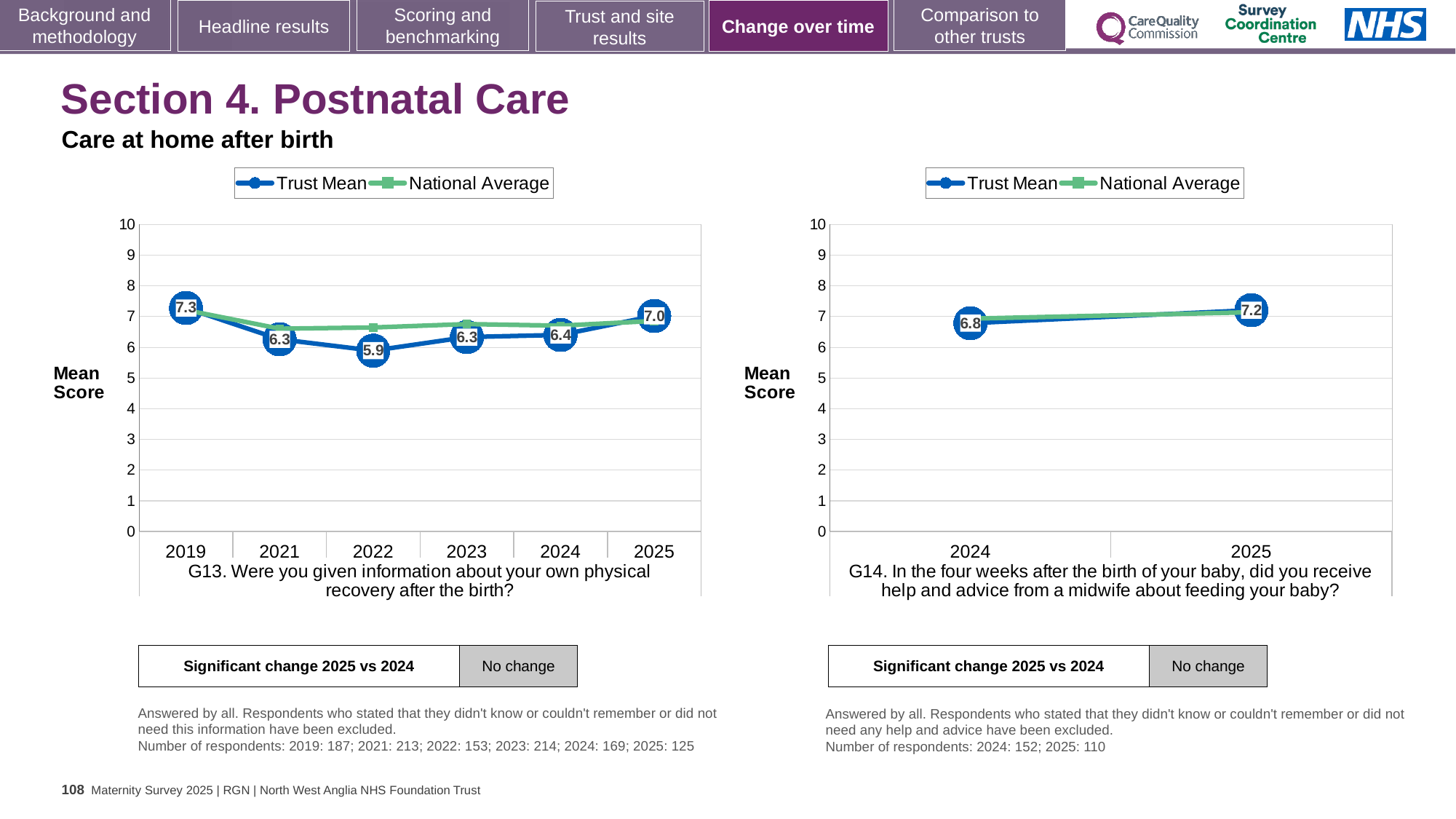
In the G14 chart on the right, what is the difference between the Trust Mean scores for 2025 and 2024? 0.4 In the G13 chart on the left, which year has the highest Trust Mean score? 2019 In the G13 chart on the left, what is the Trust Mean score for 2022? 5.9 In the G14 chart on the right, does the Trust Mean rise or fall from 2024 to 2025? rise In the G13 chart on the left, which year has the lowest Trust Mean score? 2022 In the G13 chart on the left, what is the Trust Mean score for 2019? 7.3 In the G14 chart on the right, what is the Trust Mean score for 2024? 6.8 In the G13 chart on the left, what is the difference between the Trust Mean scores for 2019 and 2022? 1.4 In the G13 chart on the left, what is the Trust Mean score for 2025? 7.0 In the G13 chart on the left, how many years are shown on the x axis? 6 In the G14 chart on the right, is the National Average value for 2024 greater or less than 5? greater How many series does the legend of the G13 chart on the left list? 2